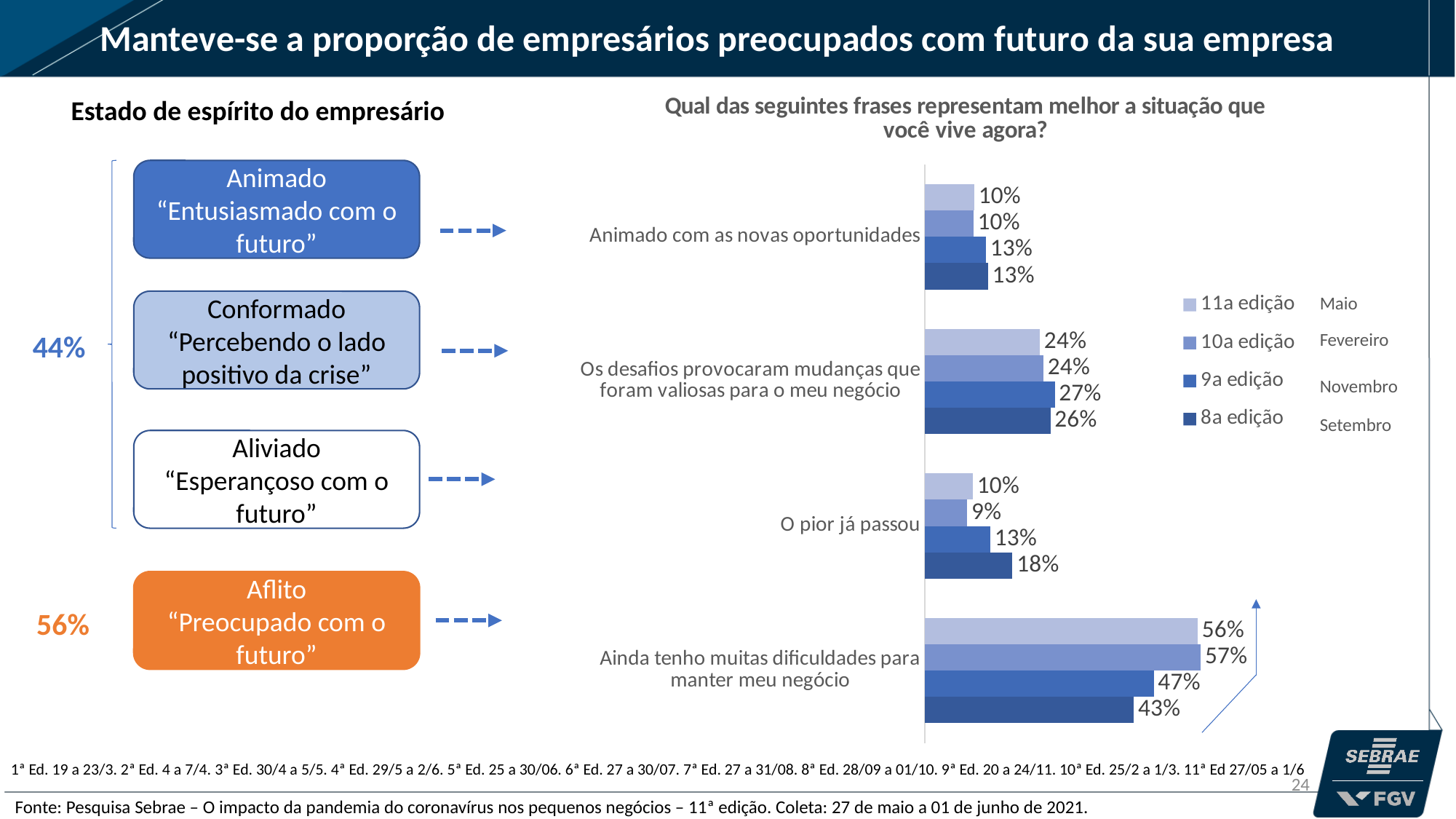
What is the difference between the 10a edição and 8a edição values for "Ainda tenho muitas dificuldades para manter meu negócio"? 14% What is the value for "Animado com as novas oportunidades" in the 10a edição series? 10% What is the value for "Ainda tenho muitas dificuldades para manter meu negócio" in the 11a edição series? 56% What kind of chart is shown on the slide? bar chart What is the value for "Os desafios provocaram mudanças que foram valiosas para o meu negócio" in the 9a edição series? 27% How many series does the chart legend list? 4 For "O pior já passou", which series has the larger value: 9a edição or 8a edição? 8a edição What is the value for "O pior já passou" in the 8a edição series? 18% Which category has the highest value in the 11a edição series? Ainda tenho muitas dificuldades para manter meu negócio Which month does the legend associate with the 11a edição series? Maio How many categories (statements) are plotted in the chart? 4 Which category has the lowest value in the 10a edição series? O pior já passou